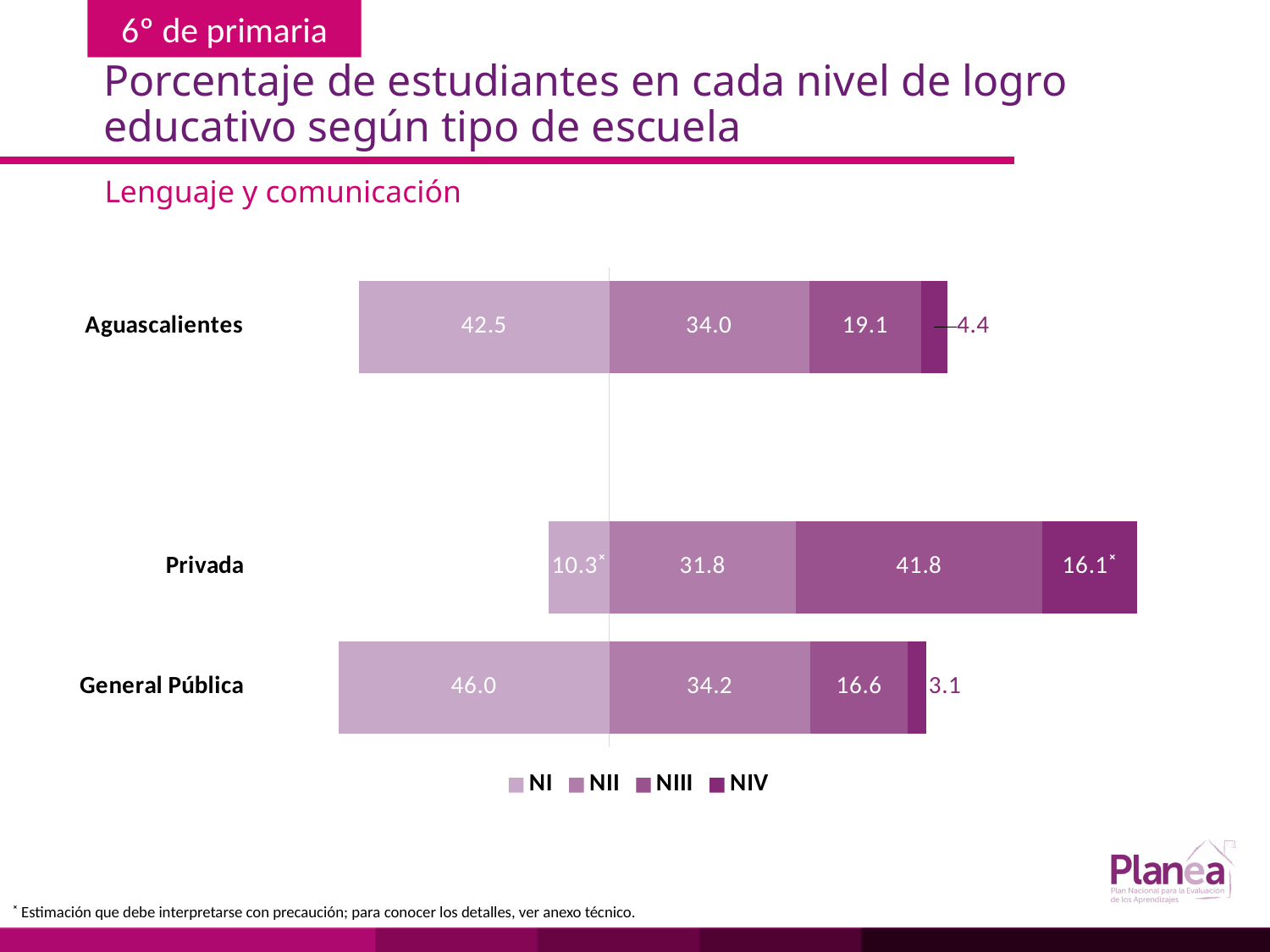
Which school type has the lowest NIV value? General Pública What is the NIII value for Privada schools? 41.8 How many series does the legend list? 4 What kind of chart is shown on the slide? Stacked bar chart What is the total of the stacked bar for Privada? 100.0 What is the NIV value for General Pública? 3.1 What is the difference between the NIV values for Privada and Aguascalientes? 11.7 Which school type has the highest NI value? General Pública How many school types (categories) are shown in the chart? 3 Which is larger, the NII value for General Pública or the NII value for Privada? General Pública Which subject does the chart cover, according to the subtitle? Lenguaje y comunicación What percentage of Aguascalientes students are at level NI? 42.5